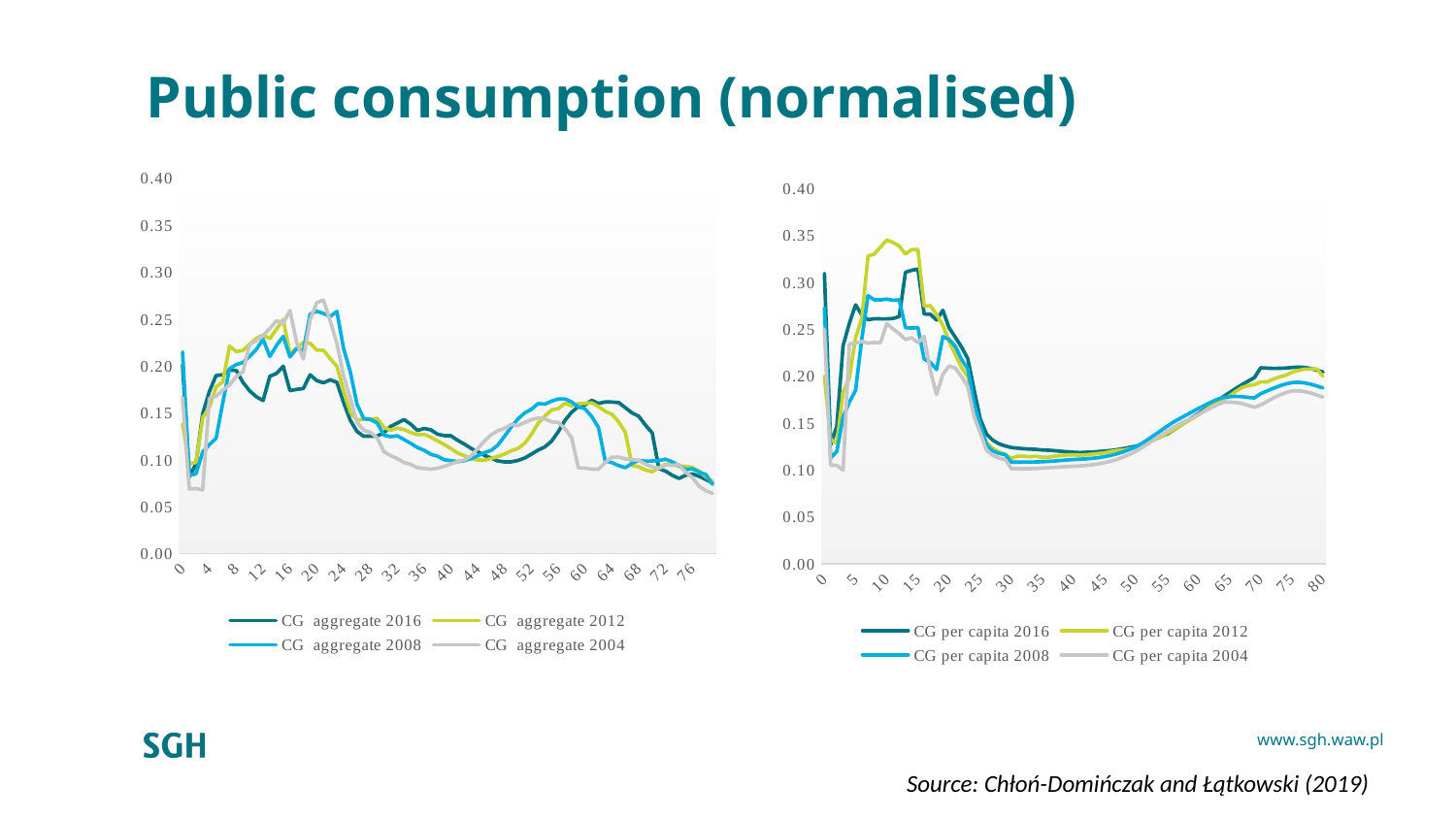
In the right chart (CG per capita), is the value for CG per capita 2012 at age 10 greater or less than 0.30? greater In the right chart (CG per capita), which series is larger at age 10: CG per capita 2012 or CG per capita 2004? CG per capita 2012 What is the title of the slide containing the two charts? Public consumption (normalised) In the right chart (CG per capita), is the value for CG per capita 2008 at age 40 greater or less than 0.15? less In the right chart (CG per capita), which series reaches the highest peak value? CG per capita 2012 How many series does the legend of the right chart (CG per capita) list? 4 What kind of chart is the left chart (CG aggregate)? line chart How many series does the legend of the left chart (CG aggregate) list? 4 In the left chart (CG aggregate), is the value for CG aggregate 2004 at age 4 greater or less than 0.10? greater In the right chart (CG per capita), does the CG per capita 2016 line rise or fall between age 30 and age 70? rise